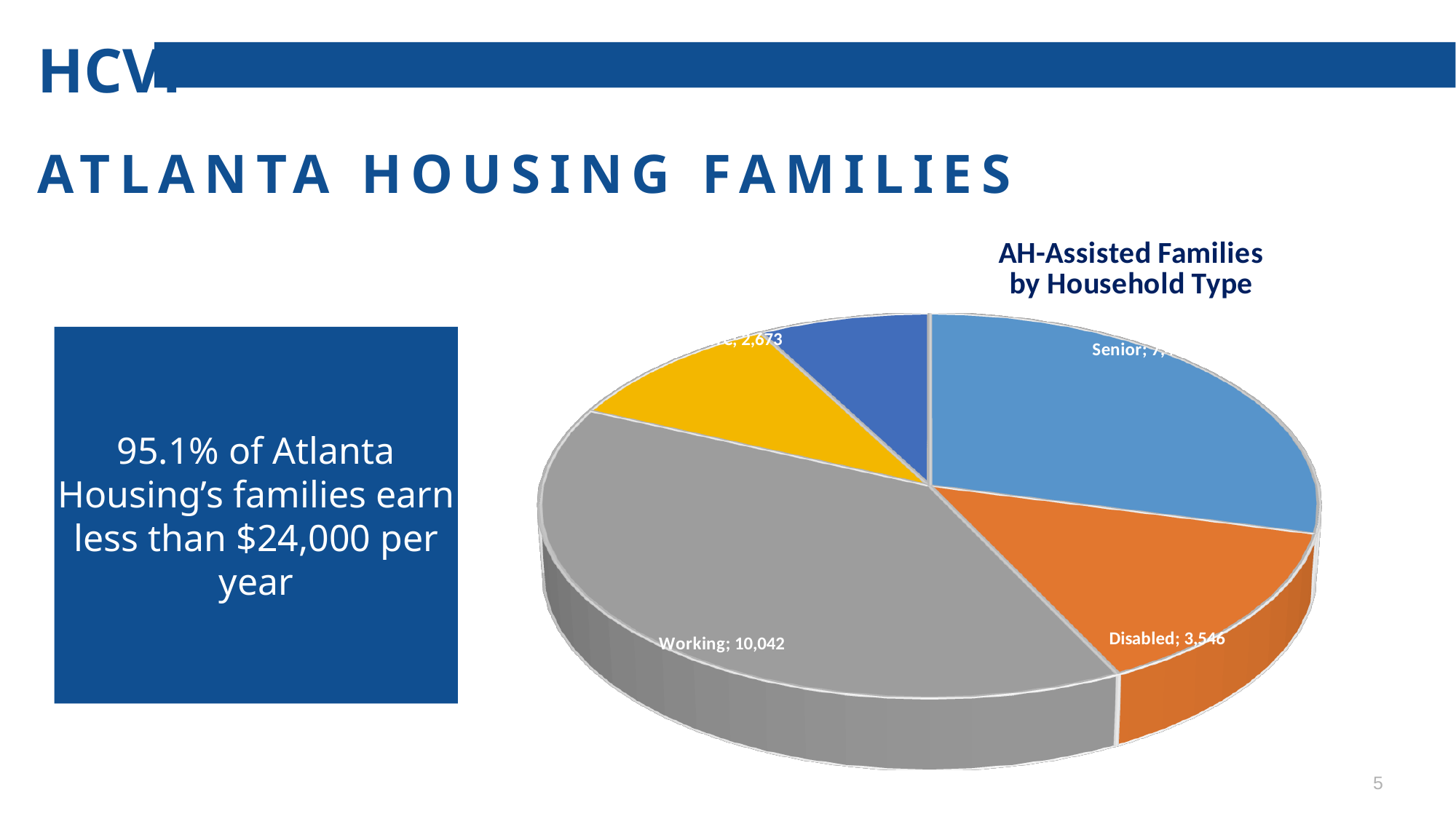
What is the difference between the Working and Disabled values in the pie chart? 6,496 How many families are in the Working category in the AH-Assisted Families by Household Type pie chart? 10,042 What is the value shown for the Disabled slice of the pie chart? 3,546 How many slices does the pie chart have? 5 Which household type has the largest slice in the pie chart? Working Which slice is larger in the pie chart, Senior or Disabled? Senior Which is larger in the pie chart, Working or Disabled? Working What kind of chart is shown on the slide? Pie chart What colour is the Working slice in the pie chart? Gray What is the title of the pie chart? AH-Assisted Families by Household Type